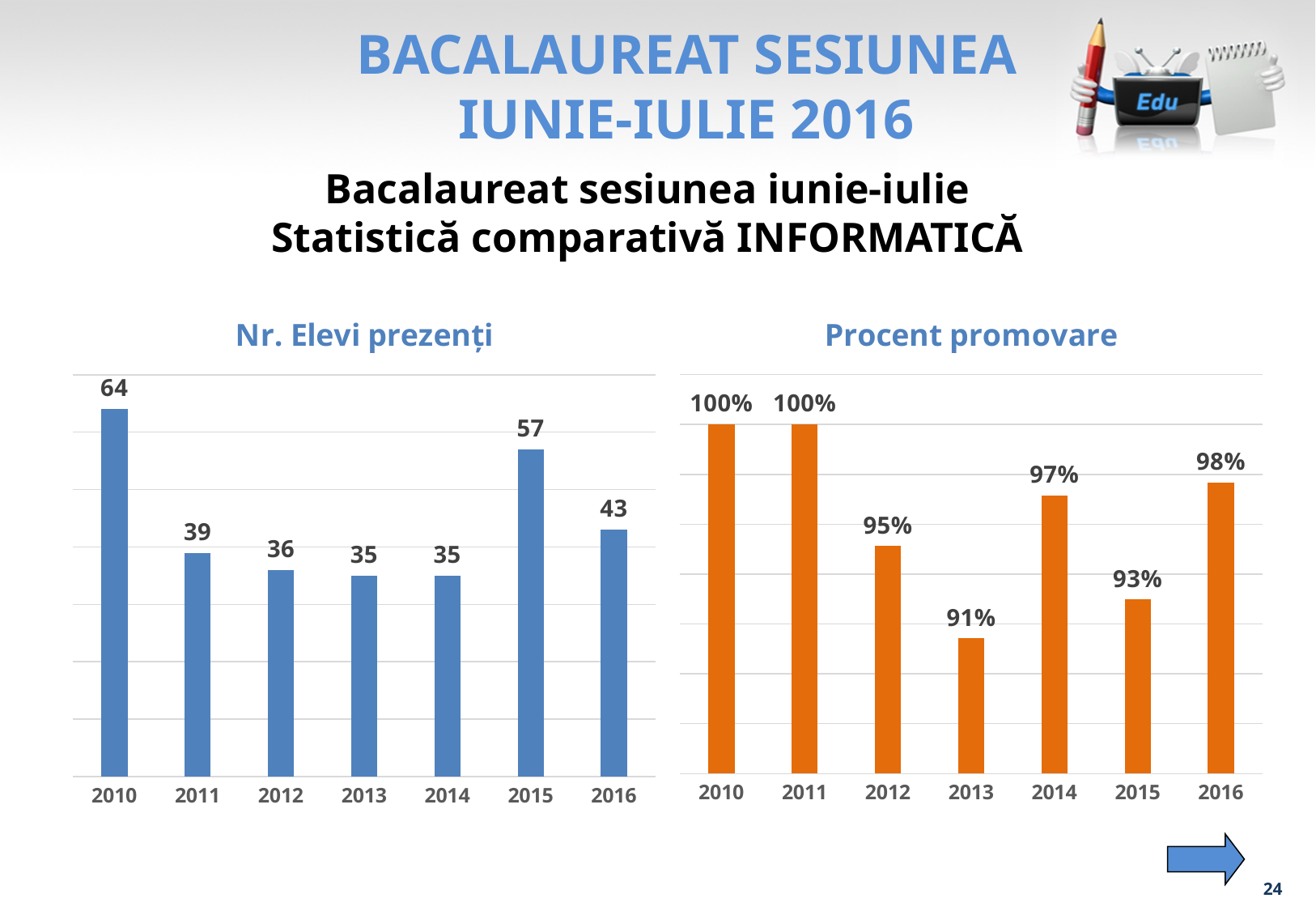
In the 'Nr. Elevi prezenți' chart, how many years are shown on the x axis? 7 In the 'Procent promovare' chart, which year has the lowest value? 2013 In the 'Nr. Elevi prezenți' chart, what kind of chart is it? Bar chart In the 'Procent promovare' chart, what is the difference between the values for 2016 and 2013? 7% In the 'Nr. Elevi prezenți' chart, which year has the lowest value? 2013 and 2014 (35) In the 'Procent promovare' chart, is the value for 2014 larger or smaller than the value for 2015? Larger In the 'Procent promovare' chart, which years have the highest value? 2010 and 2011 What colour are the bars in the 'Procent promovare' chart? Orange In the 'Nr. Elevi prezenți' chart, what is the value for 2010? 64 In the 'Procent promovare' chart, what is the value for 2016? 98% In the 'Nr. Elevi prezenți' chart, what is the difference between the values for 2015 and 2016? 14 In the 'Procent promovare' chart, what is the value for 2013? 91%